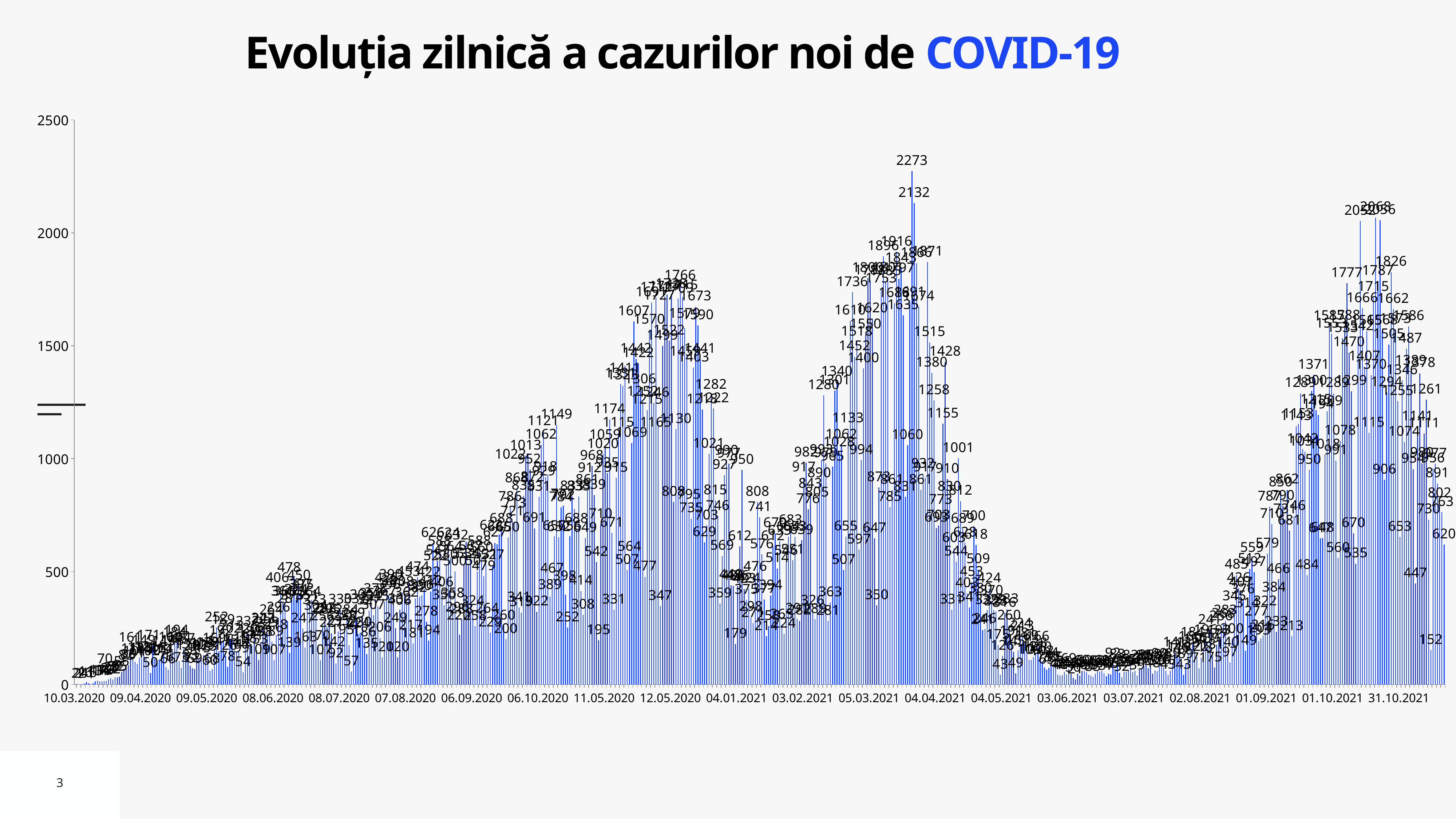
What is the highest daily value labeled on the chart? 2273 Between 03.07.2021 and 31.10.2021, do the values generally rise or fall? rise What kind of chart is shown on the slide? bar chart What is the title of the chart? Evoluția zilnică a cazurilor noi de COVID-19 What is the maximum value shown on the vertical axis? 2500 Between 04.04.2021 and 03.06.2021, do the values generally rise or fall? fall What is the first date label on the horizontal axis? 10.03.2020 Which is higher, the tallest bar near 04.04.2021 or the tallest bar near 12.05.2020? the tallest bar near 04.04.2021 What is the difference between the two highest labeled values, 2273 and 2132? 141 What is the second-highest value labeled on the chart, next to the 2273 peak? 2132 What is the last date label on the horizontal axis? 31.10.2021 Is the highest value on the chart greater or less than 2000? greater